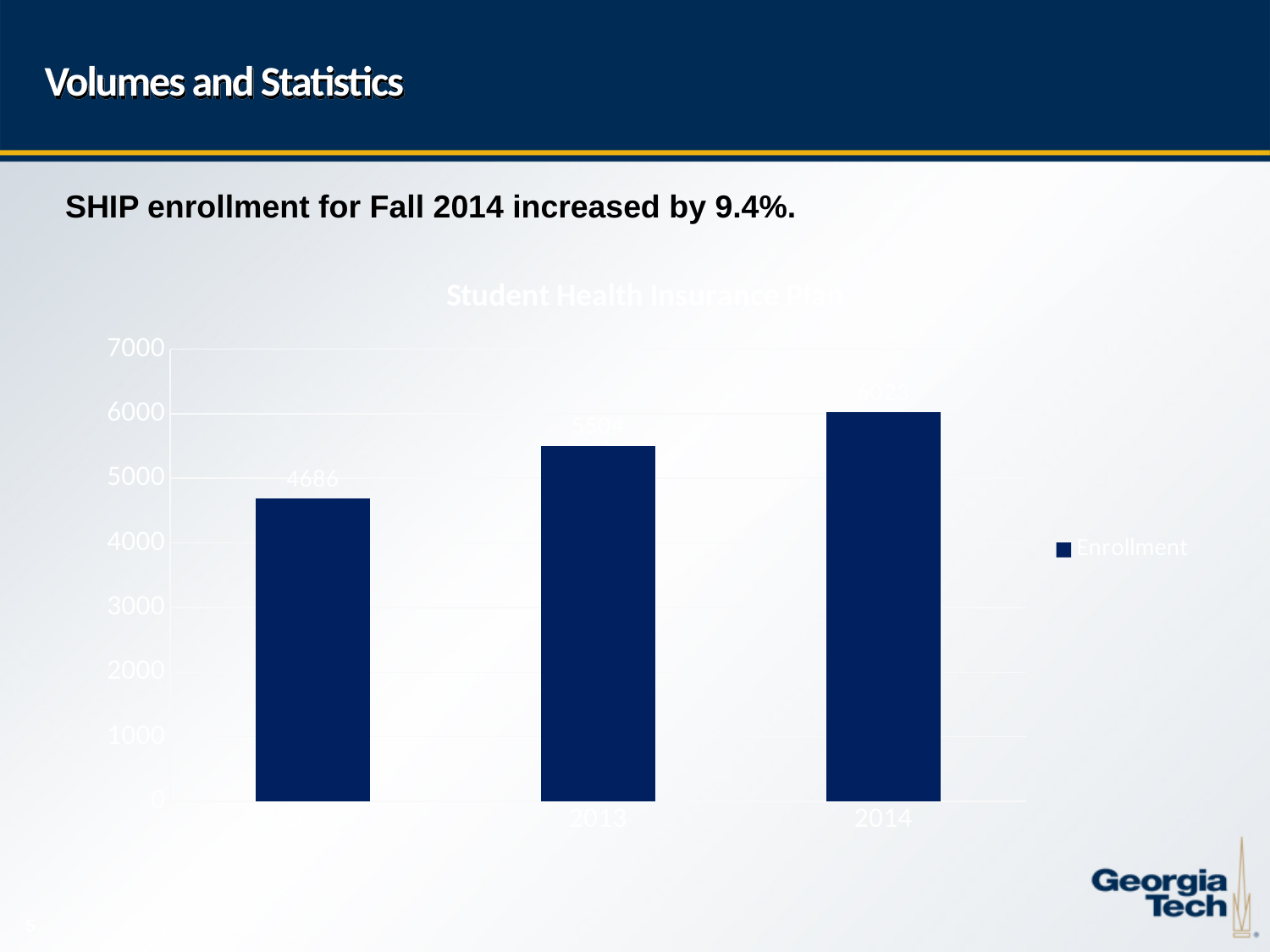
What is the title of the chart? Student Health Insurance Plan What kind of chart is shown on the slide? bar chart How many series does the chart legend list? 1 Is the enrollment value for 2013 greater or less than 5000? greater Which year has the highest enrollment bar? 2014 Which is larger, the enrollment for 2013 or for 2014? 2014 Is the enrollment value for 2014 greater or less than 5000? greater Do the enrollment values rise or fall from left to right across the years? rise How many bars are plotted in the chart? 3 What series name is shown in the chart legend? Enrollment Is the enrollment value for 2013 greater or less than 6000? less What value is labeled on the leftmost bar of the chart? 4686